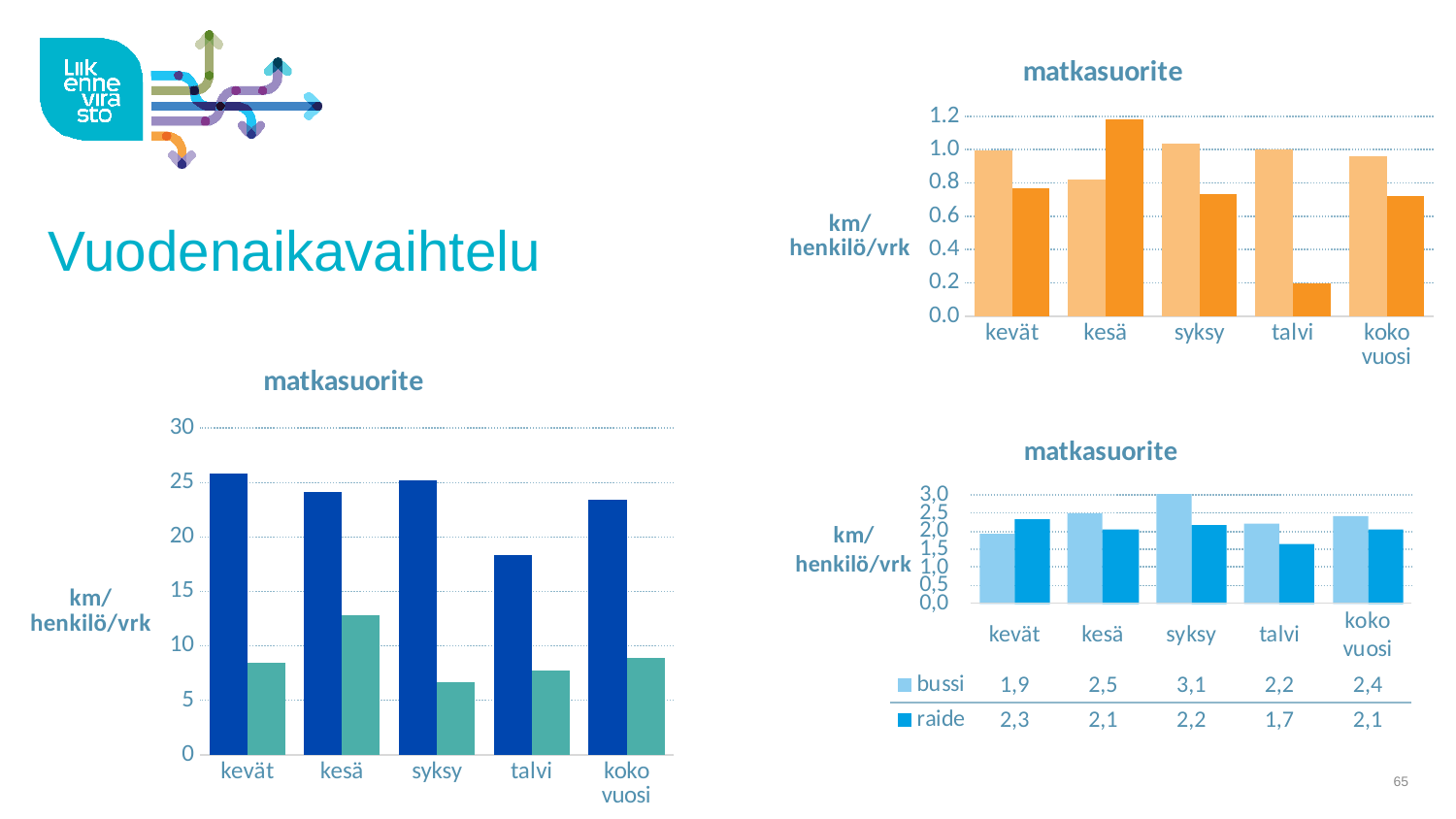
In the bottom-right chart, what is the bussi value for syksy? 3,1 In the bottom-right chart, which category has the highest bussi value? syksy In the bottom-right chart, how many series does the legend list? 2 What kind of chart is the bottom-left chart? bar chart In the bottom-right chart, what is the difference between the bussi and raide values for syksy? 0,9 In the bottom-right chart, which is larger for kevät, bussi or raide? raide In the top-right chart, is the dark orange bar for talvi greater or less than 0.4? less How many categories are shown on the x axis of the bottom-left chart? 5 In the bottom-right chart, which category has the lowest raide value? talvi In the bottom-left chart, is the dark blue bar for talvi greater or less than 20? less In the bottom-right chart, what is the raide value for talvi? 1,7 In the top-right chart, which category has the tallest dark orange bar? kesä